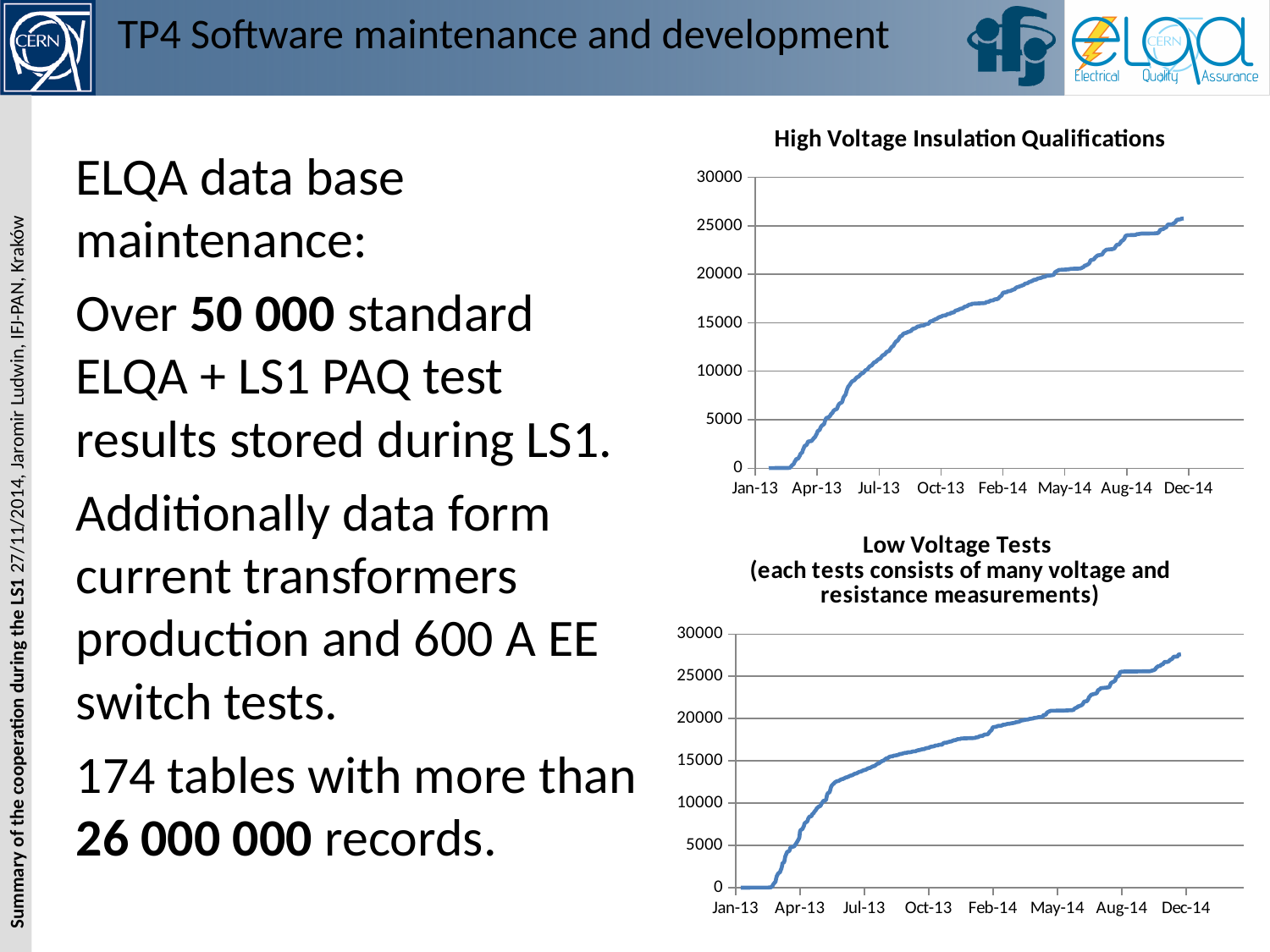
In the 'Low Voltage Tests' chart, is the value at Feb-14 greater or less than 20000? less In the 'Low Voltage Tests' chart, is the value at Jul-13 greater or less than 10000? greater In the 'Low Voltage Tests' chart, do the values rise or fall along the x axis? rise What kind of chart is the 'High Voltage Insulation Qualifications' chart? line chart In the 'High Voltage Insulation Qualifications' chart, is the value at Dec-14 greater or less than 25000? greater What is the title of the upper chart on the slide? High Voltage Insulation Qualifications What is the highest value shown on the y axis of the 'High Voltage Insulation Qualifications' chart? 30000 What kind of chart is the 'Low Voltage Tests' chart? line chart In the 'High Voltage Insulation Qualifications' chart, do the values rise or fall from Jan-13 to Dec-14? rise